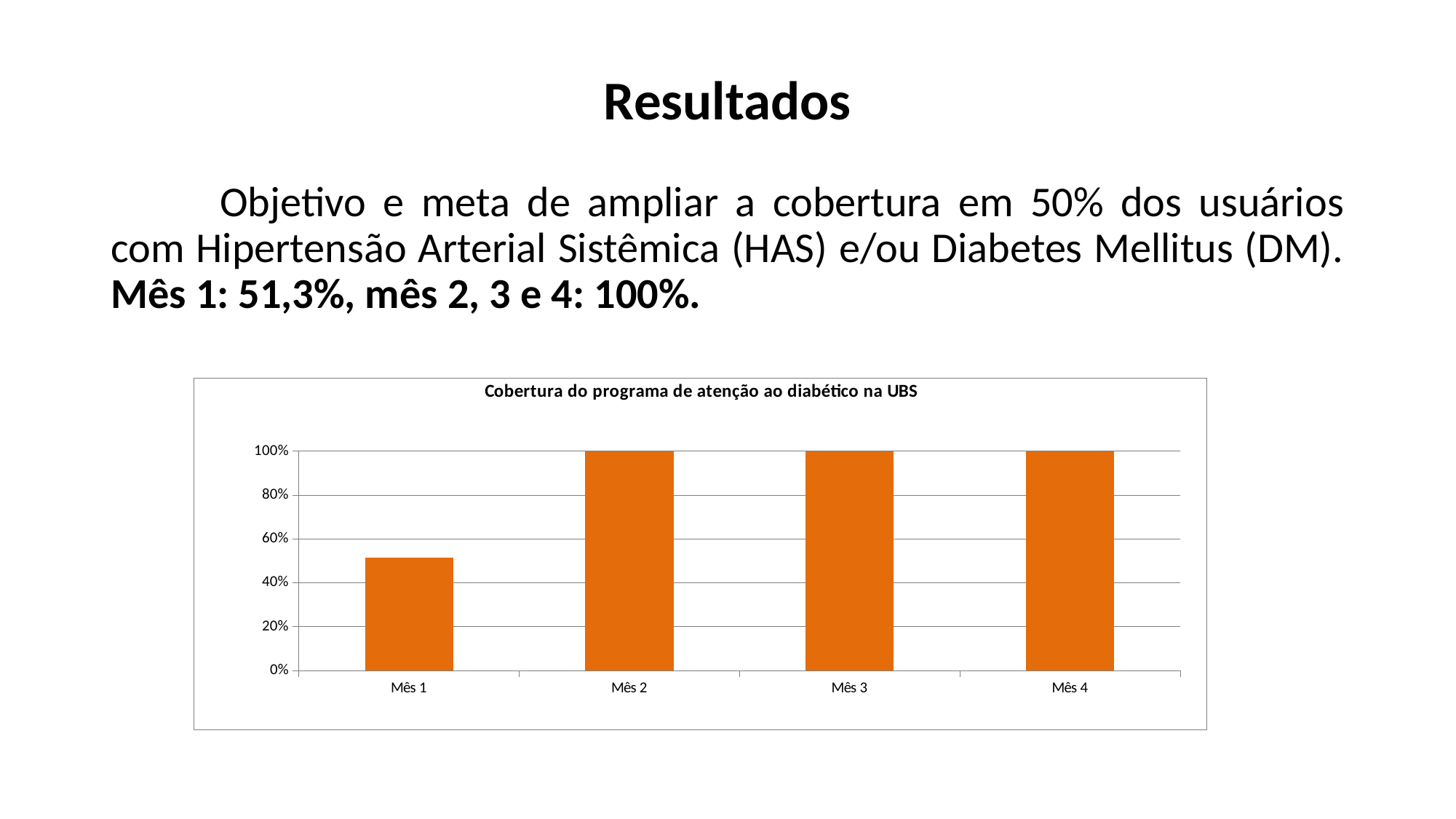
What is the coverage value for Mês 2? 100% Is the value for Mês 3 greater or less than 80%? greater Is the value for Mês 1 greater or less than 40%? greater What is the coverage value for Mês 1? 51,3% Which month has the lowest coverage? Mês 1 Which is larger, the value for Mês 1 or the value for Mês 2? Mês 2 What type of chart is shown on the slide? bar chart What is the coverage value for Mês 4? 100% What is the title of the chart? Cobertura do programa de atenção ao diabético na UBS How many months (categories) are shown on the x axis of the chart? 4 Is the value for Mês 1 greater or less than 60%? less What colour are the bars in the chart? orange